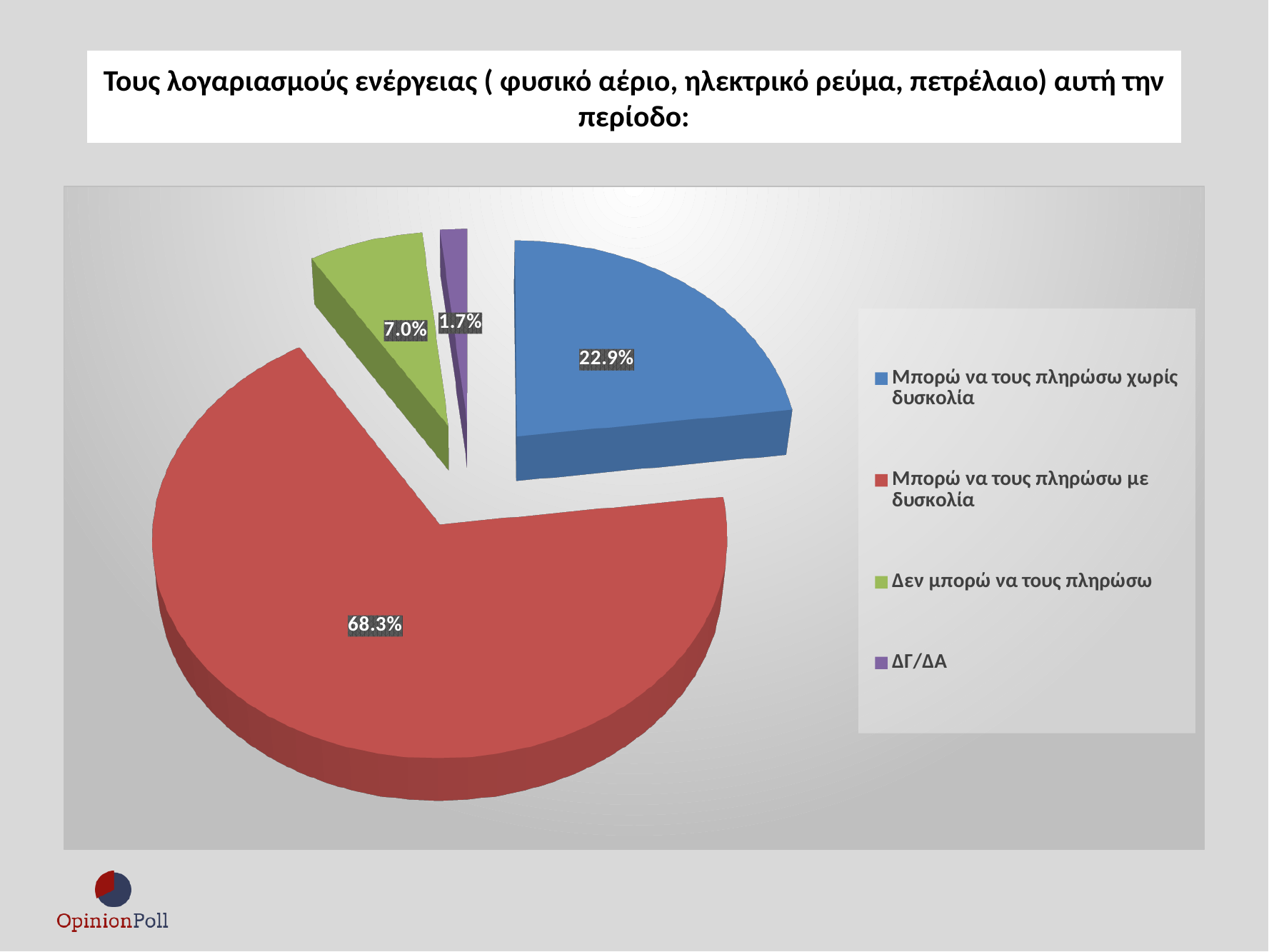
What share of respondents answered "Δεν μπορώ να τους πληρώσω"? 7.0% What is the difference in percentage points between "Μπορώ να τους πληρώσω με δυσκολία" and "Μπορώ να τους πληρώσω χωρίς δυσκολία"? 45.4 Which is larger: the share for "Δεν μπορώ να τους πληρώσω" or the share for "ΔΓ/ΔΑ"? Δεν μπορώ να τους πληρώσω What kind of chart is shown on the slide? Pie chart What is the combined share of "Μπορώ να τους πληρώσω χωρίς δυσκολία" and "Μπορώ να τους πληρώσω με δυσκολία"? 91.2% What colour is the slice for "Μπορώ να τους πληρώσω χωρίς δυσκολία"? Blue What share of respondents answered "ΔΓ/ΔΑ"? 1.7% What share of respondents answered "Μπορώ να τους πληρώσω με δυσκολία"? 68.3% Which response has the smallest slice of the pie? ΔΓ/ΔΑ What share of respondents answered "Μπορώ να τους πληρώσω χωρίς δυσκολία"? 22.9% Which response has the largest slice of the pie? Μπορώ να τους πληρώσω με δυσκολία How many slices does the pie chart have? 4